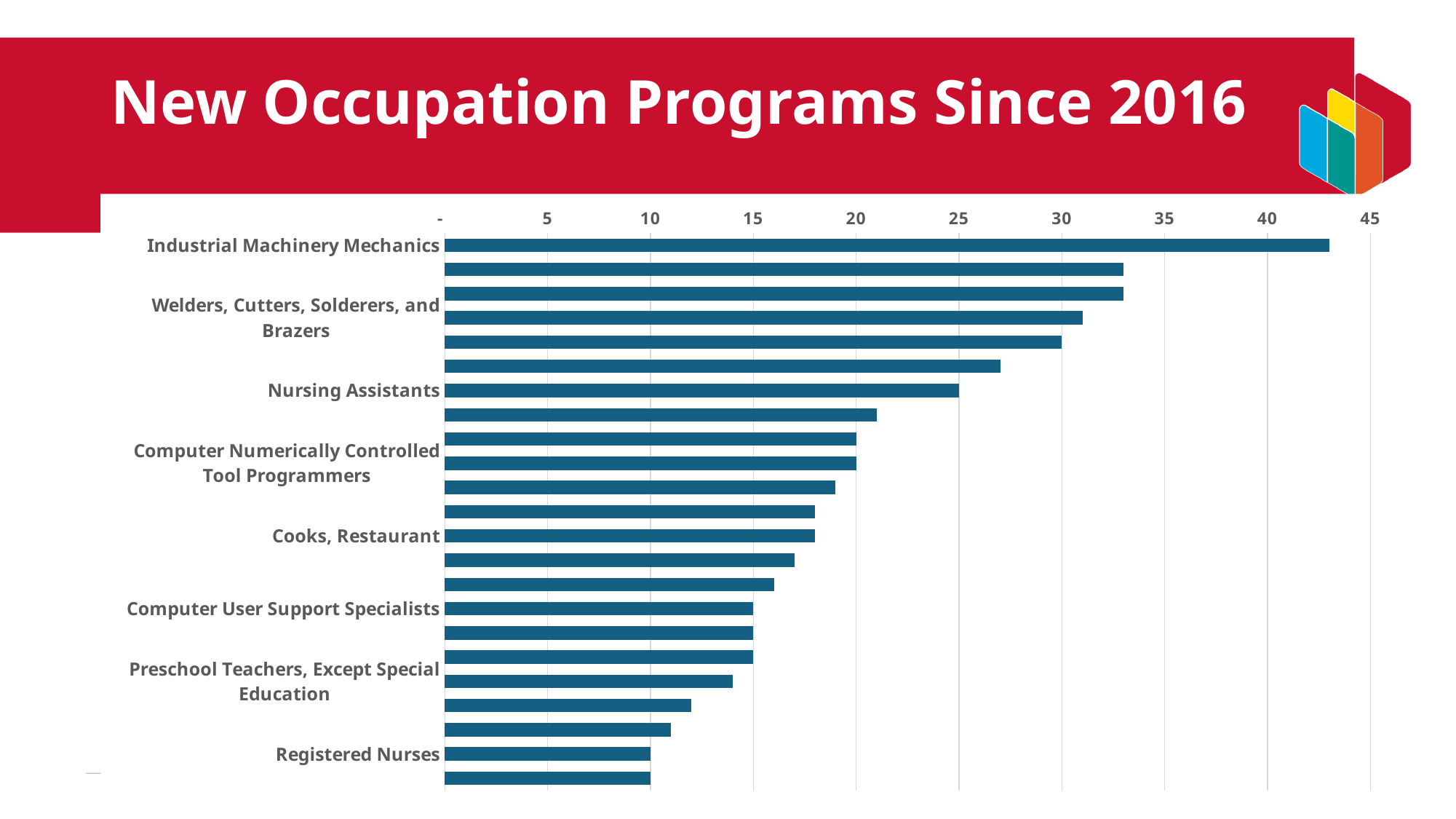
Is the value for Cooks, Restaurant greater or less than 20? less Which has a larger value, Nursing Assistants or Cooks, Restaurant? Nursing Assistants Is the value for Welders, Cutters, Solderers, and Brazers greater or less than 30? greater Do the bar values rise or fall going from the top of the chart to the bottom? fall Which labeled occupation has the highest value? Industrial Machinery Mechanics Which labeled occupation has the lowest value? Registered Nurses Is the value for Industrial Machinery Mechanics greater or less than 40? greater Which has a larger value, Welders, Cutters, Solderers, and Brazers or Computer User Support Specialists? Welders, Cutters, Solderers, and Brazers What is the title of the slide? New Occupation Programs Since 2016 What is the value for Nursing Assistants? 25 What kind of chart is shown on the slide? bar chart What is the value for Registered Nurses? 10